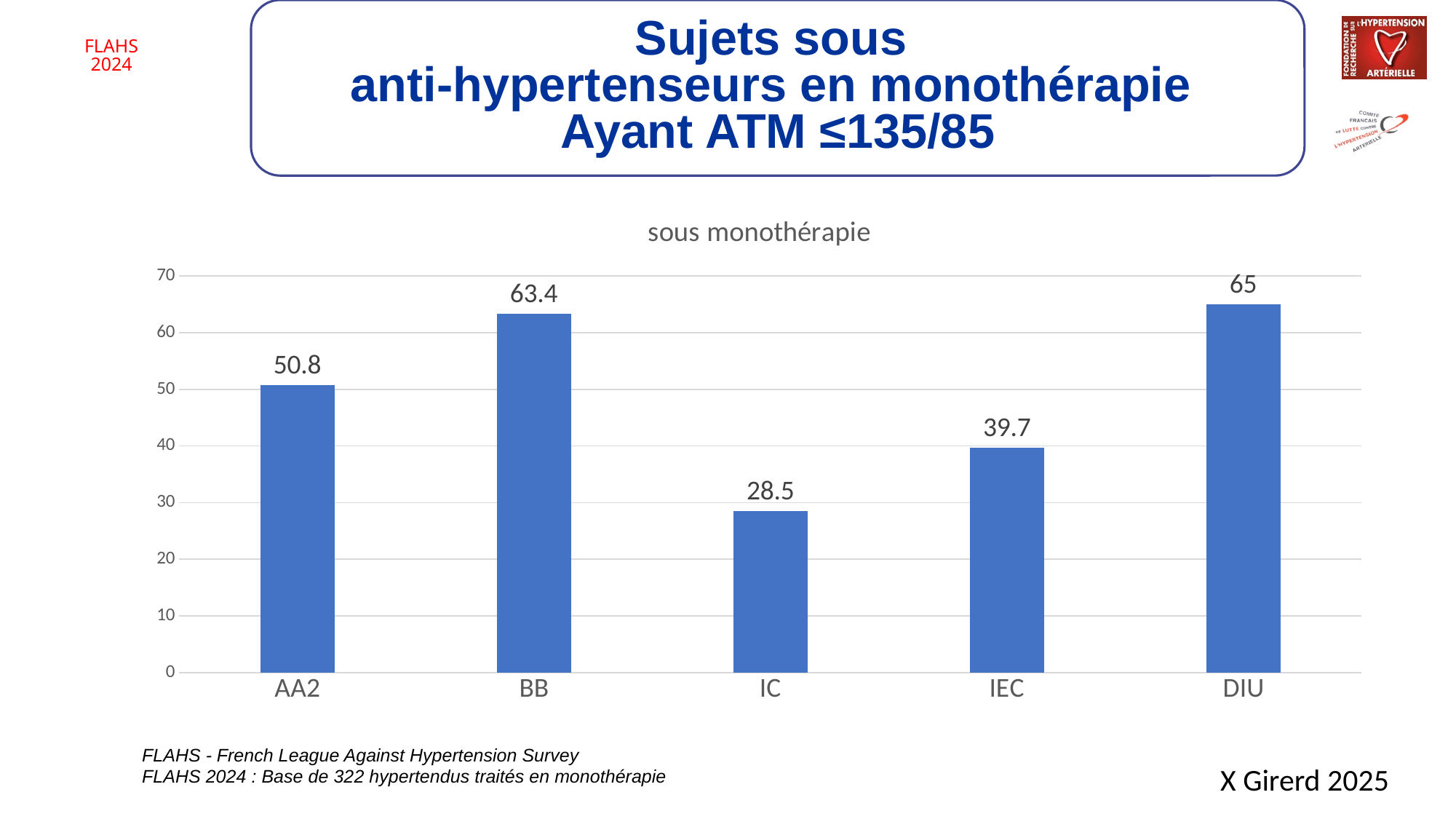
How many categories are shown on the x axis? 5 Which category has the highest value? DIU What is the title shown above the chart? sous monothérapie What is the value for IC? 28.5 Which category has the lowest value? IC What is the difference between the values for BB and IC? 34.9 Is the value for IEC greater or less than 40? less Which is larger, the value for AA2 or the value for IEC? AA2 What kind of chart is shown on the slide? bar chart What is the difference between the values for DIU and AA2? 14.2 What is the value for IEC? 39.7 What is the value for BB? 63.4